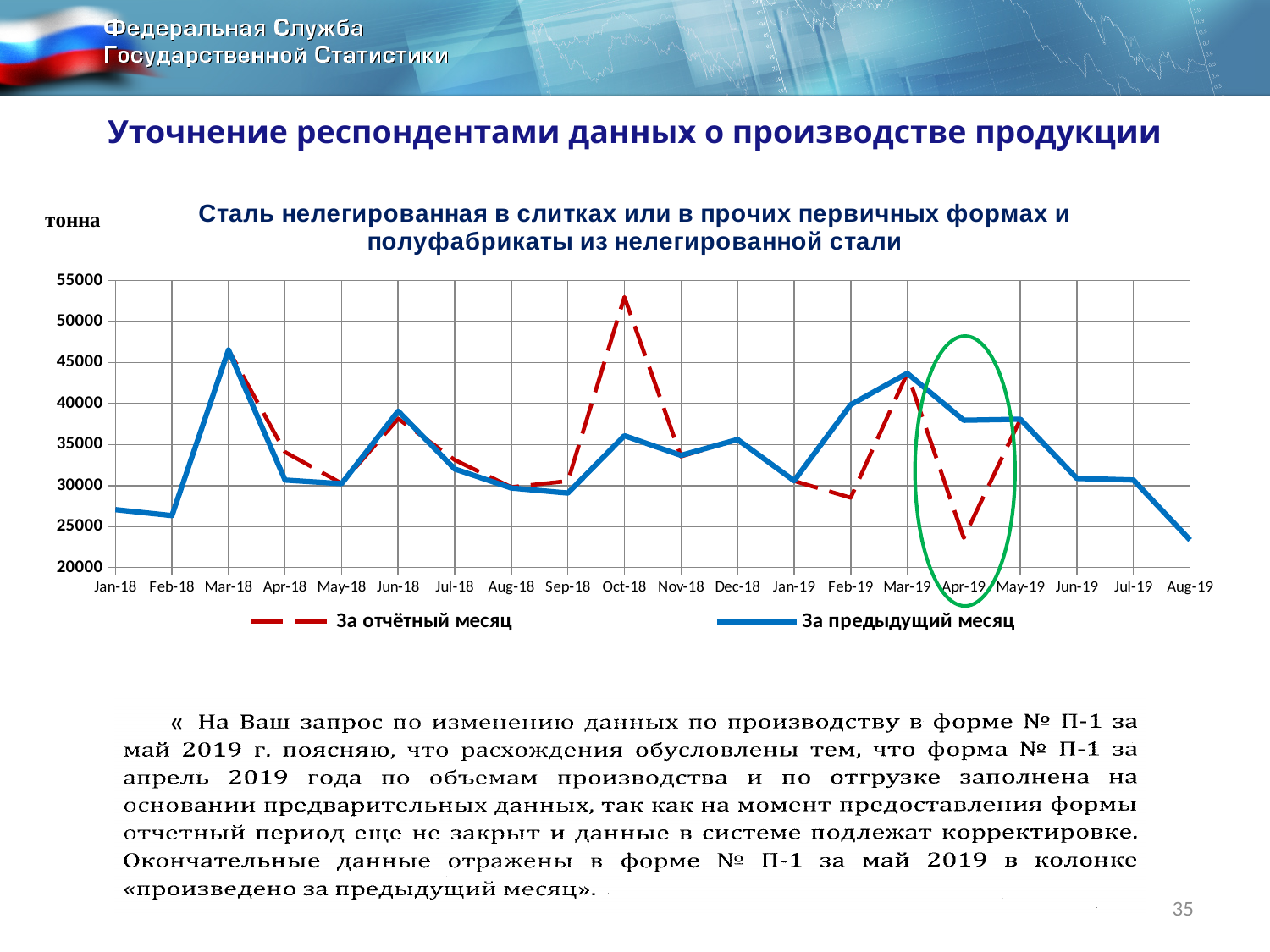
Is the value for 'За предыдущий месяц' in Mar-18 greater or less than 45000? greater In which month does the series 'За отчётный месяц' reach its highest value? Oct-18 Is the value for 'За отчётный месяц' in Oct-18 greater or less than 50000? greater In which month does the series 'За предыдущий месяц' reach its lowest value? Aug-19 Do the values of 'За предыдущий месяц' rise or fall from May-19 to Aug-19? fall In which month does the series 'За предыдущий месяц' reach its highest value? Mar-18 What unit is shown for the y axis of the chart? тонна How many series does the legend list? 2 What kind of chart is shown on the slide? line chart How many months are shown along the x axis? 20 In which month does the series 'За отчётный месяц' reach its lowest value? Aug-19 In Apr-19, which series has the larger value, 'За отчётный месяц' or 'За предыдущий месяц'? За предыдущий месяц